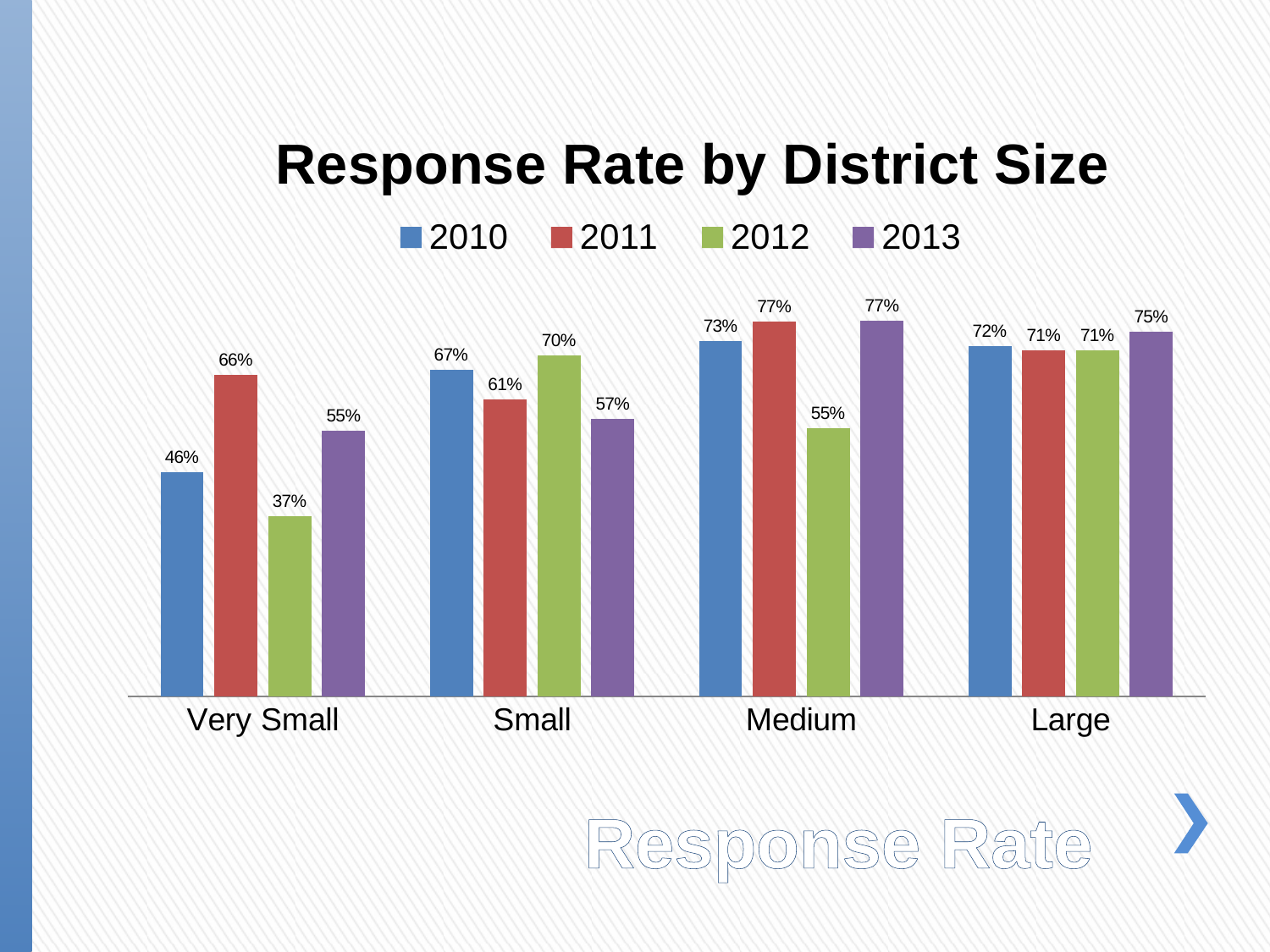
What is the difference between the 2011 and 2012 response rates for Very Small districts? 29% How many district size categories are shown on the x axis? 4 What is the 2013 response rate for Large districts? 75% What is the difference between the 2013 response rates for Medium and Small districts? 20% What is the title of the chart? Response Rate by District Size What is the 2010 response rate for Very Small districts? 46% What is the 2012 response rate for Medium districts? 55% Which district size has the lowest 2012 response rate? Very Small How many series does the legend list? 4 Which is larger, the 2010 response rate for Small districts or the 2010 response rate for Medium districts? Medium Which district size has the highest 2011 response rate? Medium What kind of chart is shown on the slide? Bar chart